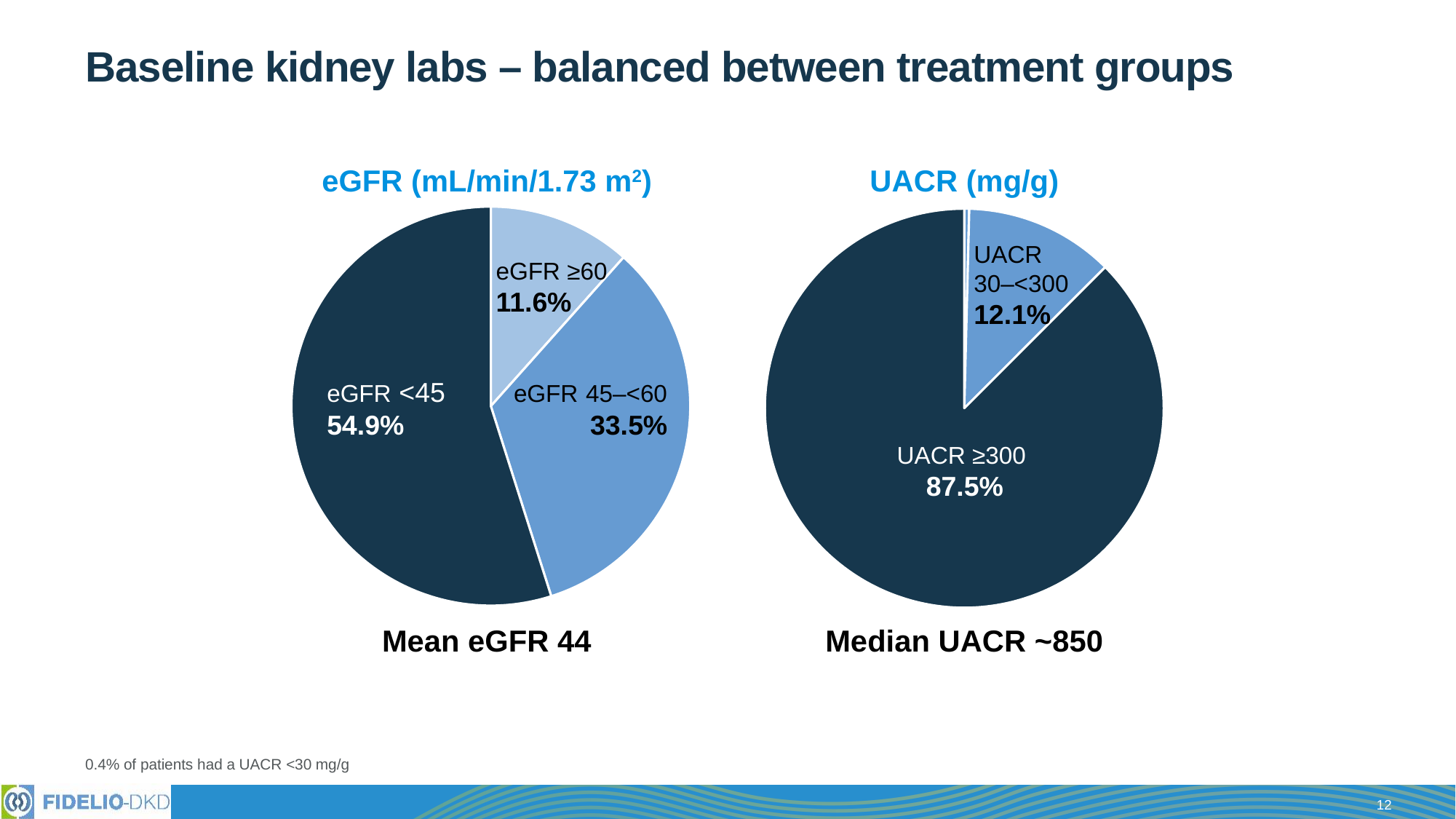
In the UACR (mg/g) pie chart, which labelled category has the largest slice? UACR ≥300 In the UACR (mg/g) pie chart, what share of patients had UACR ≥300? 87.5% What type of chart is used for the UACR (mg/g) data? Pie chart In the eGFR (mL/min/1.73 m²) pie chart, which category has the largest slice? eGFR <45 In the UACR (mg/g) pie chart, what share of patients had UACR 30–<300? 12.1% In the eGFR (mL/min/1.73 m²) pie chart, which category has the smallest slice? eGFR ≥60 In the eGFR (mL/min/1.73 m²) pie chart, how many labelled categories are shown? 3 In the eGFR (mL/min/1.73 m²) pie chart, what share of patients had eGFR 45–<60? 33.5% In the UACR (mg/g) pie chart, what is the difference in percentage points between the UACR ≥300 and UACR 30–<300 slices? 75.4 In the eGFR (mL/min/1.73 m²) pie chart, what share of patients had eGFR <45? 54.9% In the eGFR (mL/min/1.73 m²) pie chart, what is the difference in percentage points between the eGFR <45 and eGFR 45–<60 slices? 21.4 In the eGFR (mL/min/1.73 m²) pie chart, what share of patients had eGFR ≥60? 11.6%